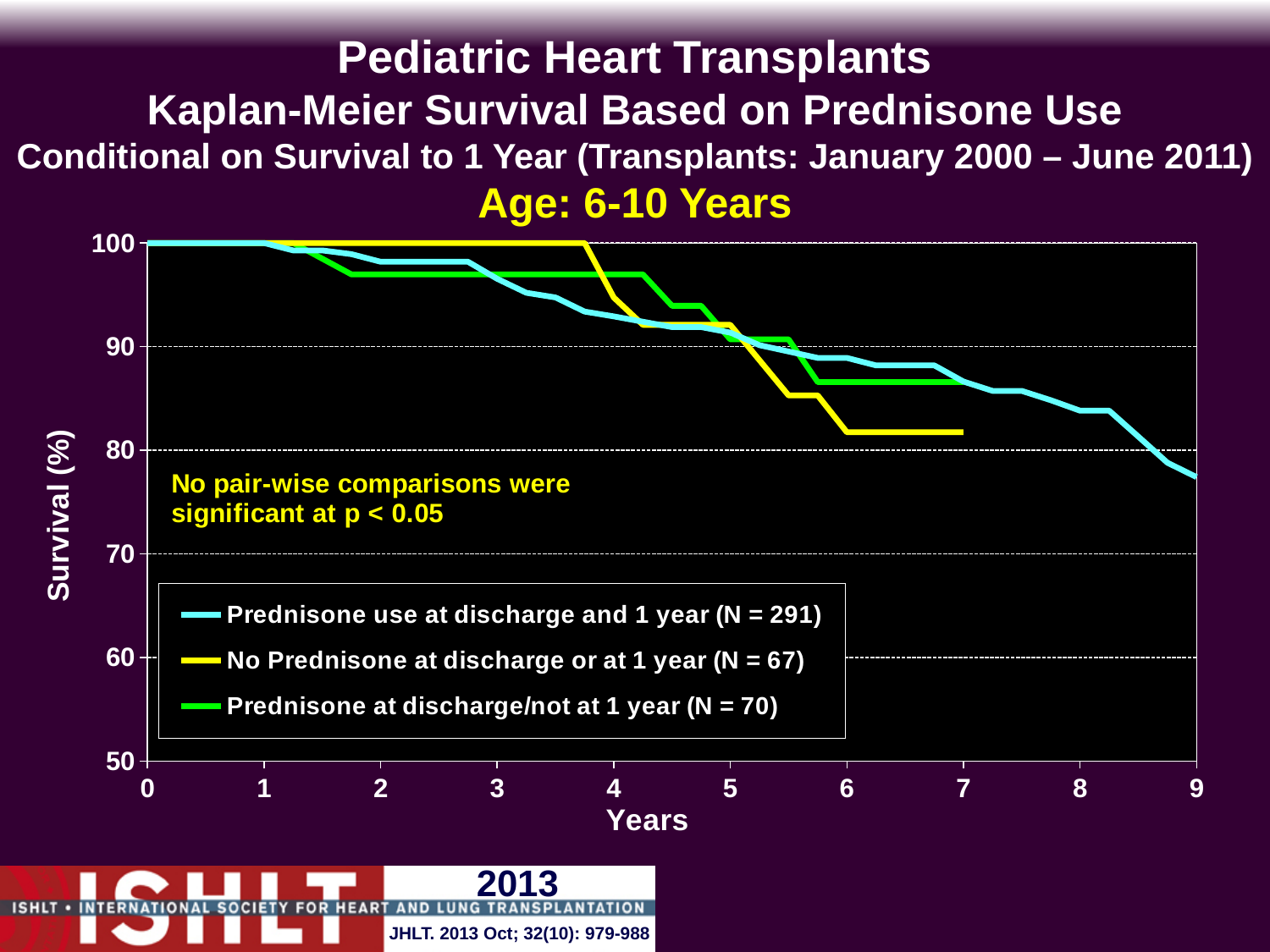
Which age group does the chart cover? 6-10 Years What kind of chart is shown on the slide? line chart At year 6, which is higher: survival for 'Prednisone use at discharge and 1 year' or for 'No Prednisone at discharge or at 1 year'? Prednisone use at discharge and 1 year Is the survival for 'No Prednisone at discharge or at 1 year' at year 7 greater or less than 80? greater How many series does the legend list? 3 What is the N for the 'Prednisone use at discharge and 1 year' series? 291 What is the N for the 'No Prednisone at discharge or at 1 year' series? 67 Is the survival for 'Prednisone use at discharge and 1 year' at year 9 greater or less than 80? less What is the N for the 'Prednisone at discharge/not at 1 year' series? 70 Is the survival for 'Prednisone use at discharge and 1 year' at year 2 greater or less than 90? greater At year 7, which series has the lowest survival? No Prednisone at discharge or at 1 year Do the survival curves rise or fall as years increase? fall